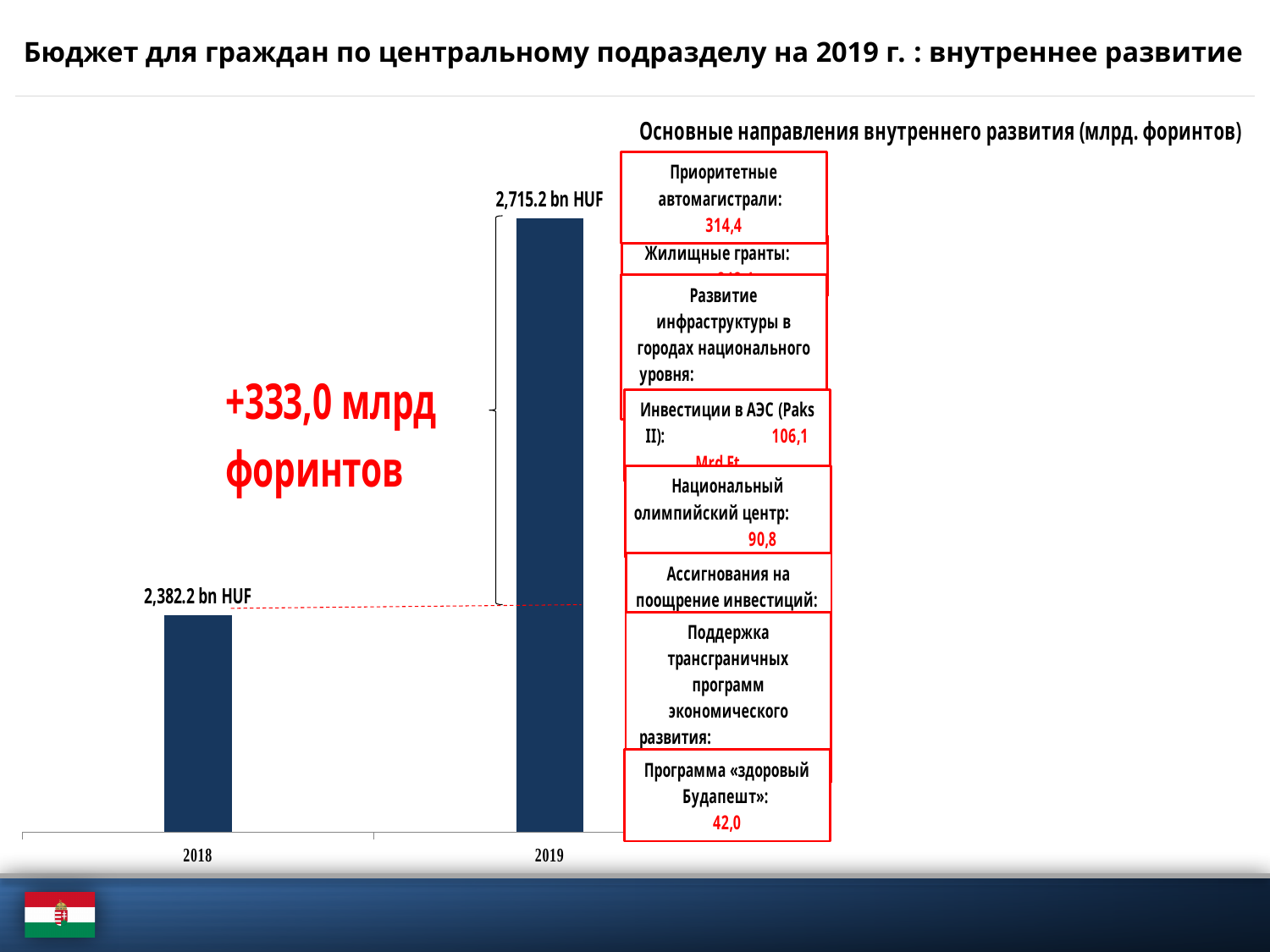
What colour are the bars in the chart? dark blue Which year has the higher bar? 2019 What is the value of the bar for 2018? 2,382.2 bn HUF Which year has the lower bar? 2018 What is the value of the bar for 2019? 2,715.2 bn HUF What increase is written in large red text next to the bars? +333,0 млрд форинтов By how much does the 2019 value exceed the 2018 value? 333.0 bn HUF How many bars are plotted in the chart? 2 Is the value for 2019 larger or smaller than the value for 2018? larger What type of chart is shown on the slide? bar chart Do the values rise or fall from 2018 to 2019? rise